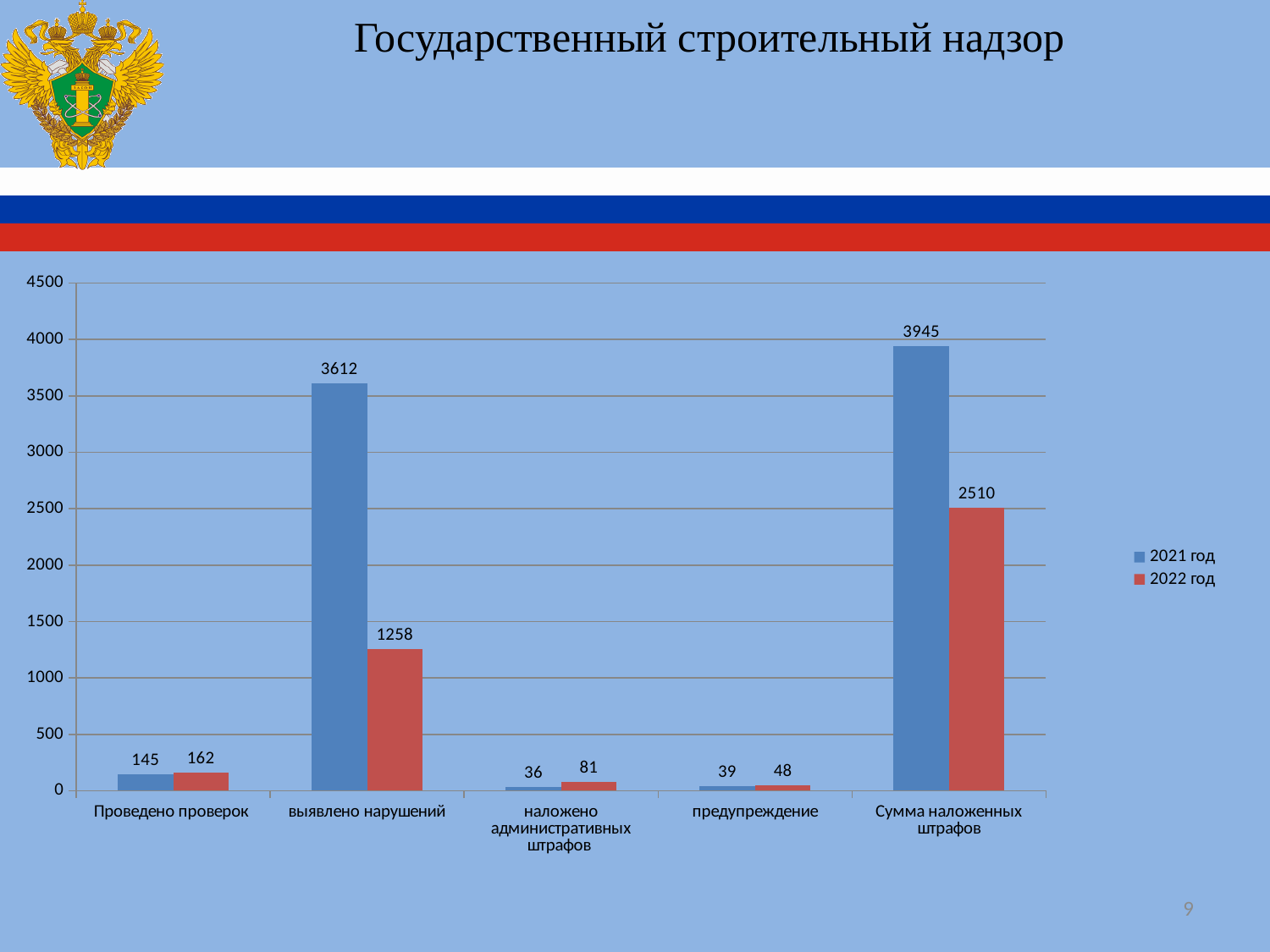
What is the value for 'предупреждение' in the 2021 год series? 39 What kind of chart is shown on the slide? bar chart What is the value for 'наложено административных штрафов' in the 2022 год series? 81 What is the value for 'выявлено нарушений' in the 2022 год series? 1258 Which is larger for 'выявлено нарушений': the 2021 год value or the 2022 год value? 2021 год What is the difference between the 2021 год and 2022 год values for 'Сумма наложенных штрафов'? 1435 Which category has the lowest value in the 2022 год series? предупреждение How many categories are shown on the x axis? 5 Is the 2022 год value for 'Сумма наложенных штрафов' greater or less than 3000? less Which category has the highest value in the 2021 год series? Сумма наложенных штрафов What is the value for 'Проведено проверок' in the 2021 год series? 145 How many series does the legend list? 2